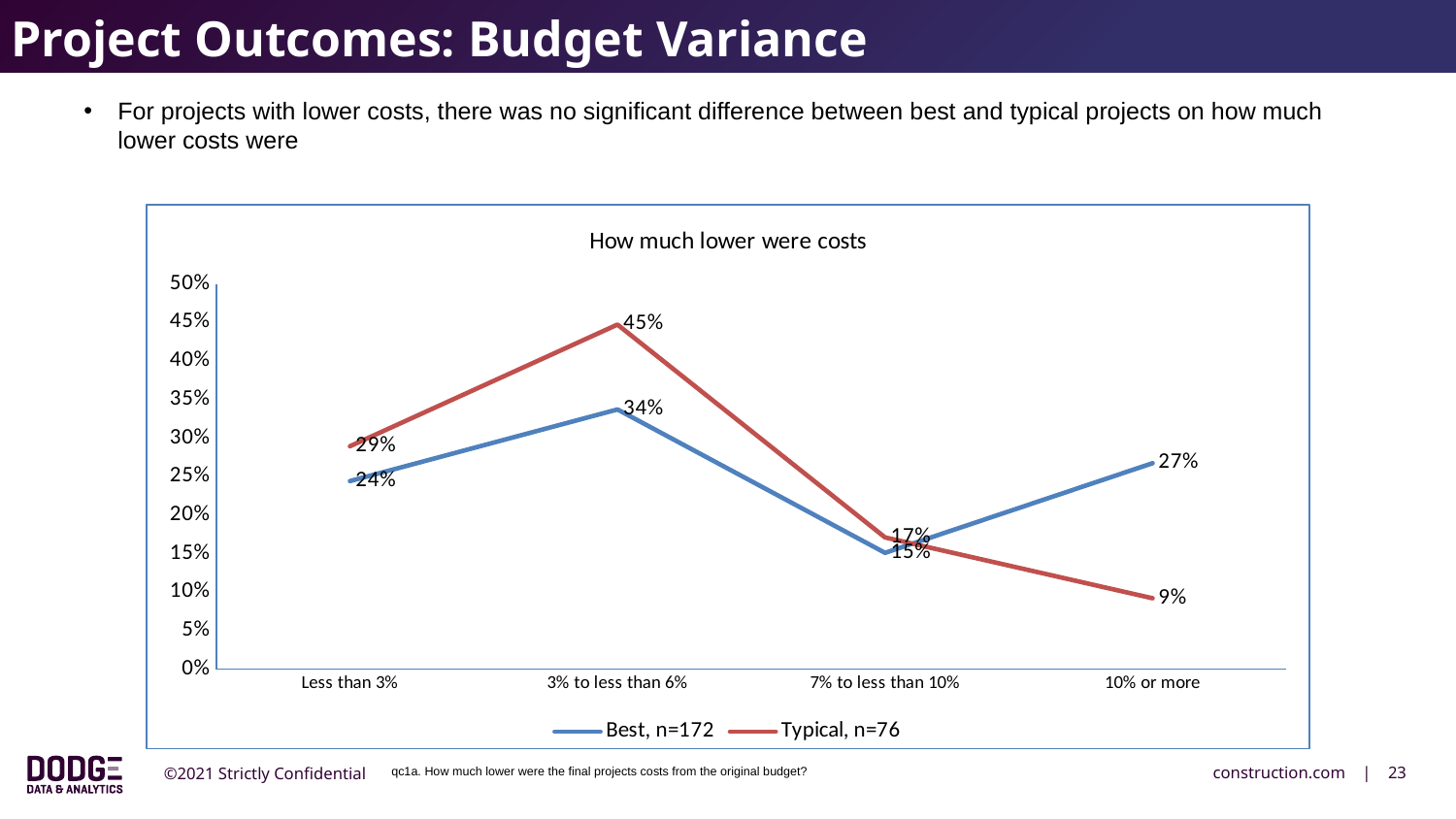
What is the difference between Typical, n=76 and Best, n=172 at '3% to less than 6%'? 11% Which category has the highest value for Typical, n=76? 3% to less than 6% How many categories are shown on the x axis? 4 Which category has the lowest value for Best, n=172? 7% to less than 10% Does the Typical, n=76 line rise or fall from '7% to less than 10%' to '10% or more'? fall What type of chart is shown on the slide? line chart What is the title of the chart? How much lower were costs What is the value for Best, n=172 at '3% to less than 6%'? 34% What is the value for Typical, n=76 at 'Less than 3%'? 29% How many series does the legend list? 2 At '10% or more', which series has the larger value, Best, n=172 or Typical, n=76? Best, n=172 What is the value for Typical, n=76 at '10% or more'? 9%